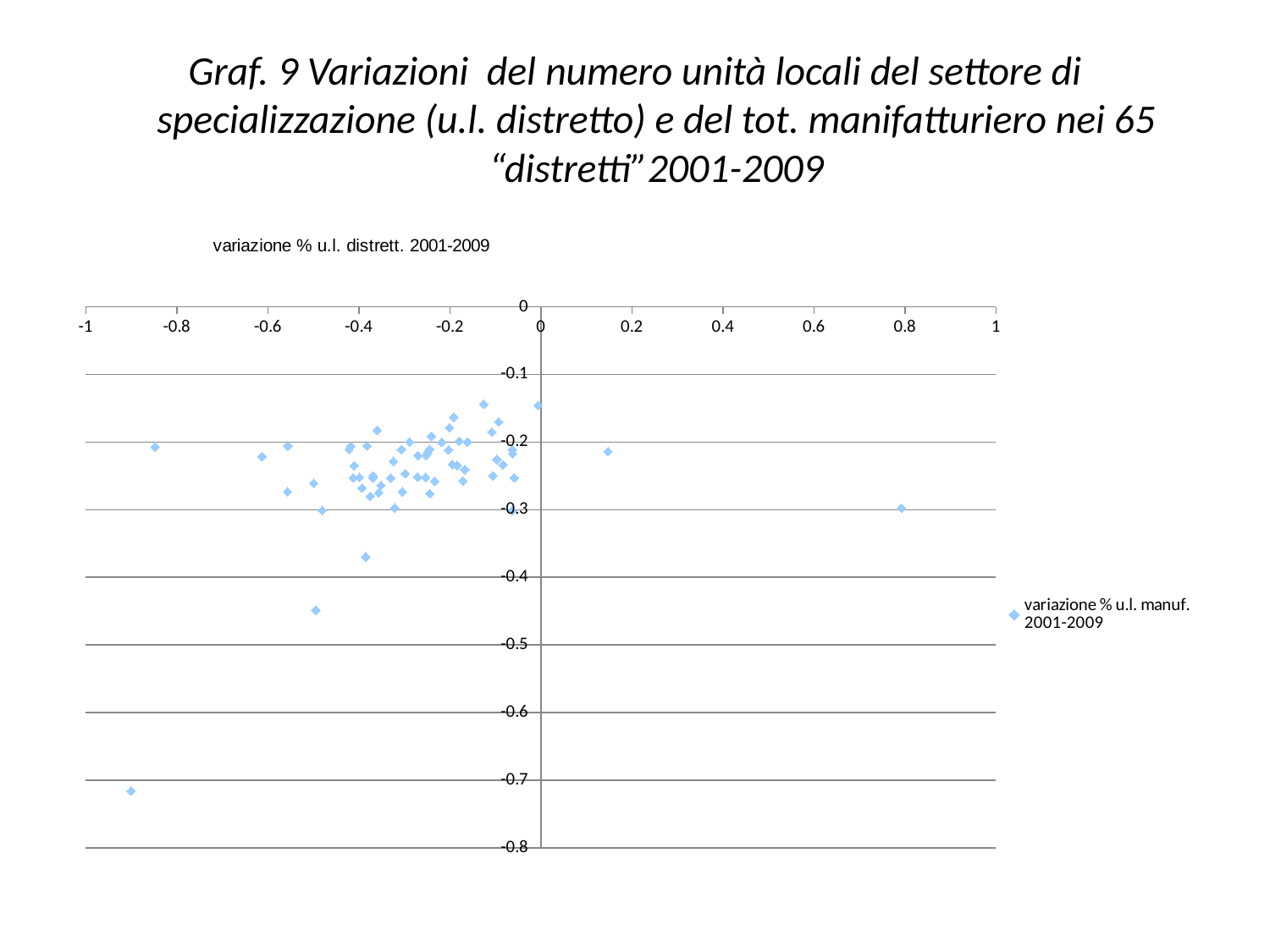
What kind of chart is shown on the slide? scatter plot Is the vertical value of the highest point on the chart greater or less than -0.2? greater Is the horizontal value of the rightmost point on the chart greater or less than 0.6? greater What label is shown above the chart for the horizontal axis variable? variazione % u.l. distrett. 2001-2009 What is the legend entry for the plotted series? variazione % u.l. manuf. 2001-2009 How many series does the legend list? 1 What is the lowest tick value shown on the vertical axis? -0.8 Is the vertical value of the lowest point on the chart greater or less than -0.7? less